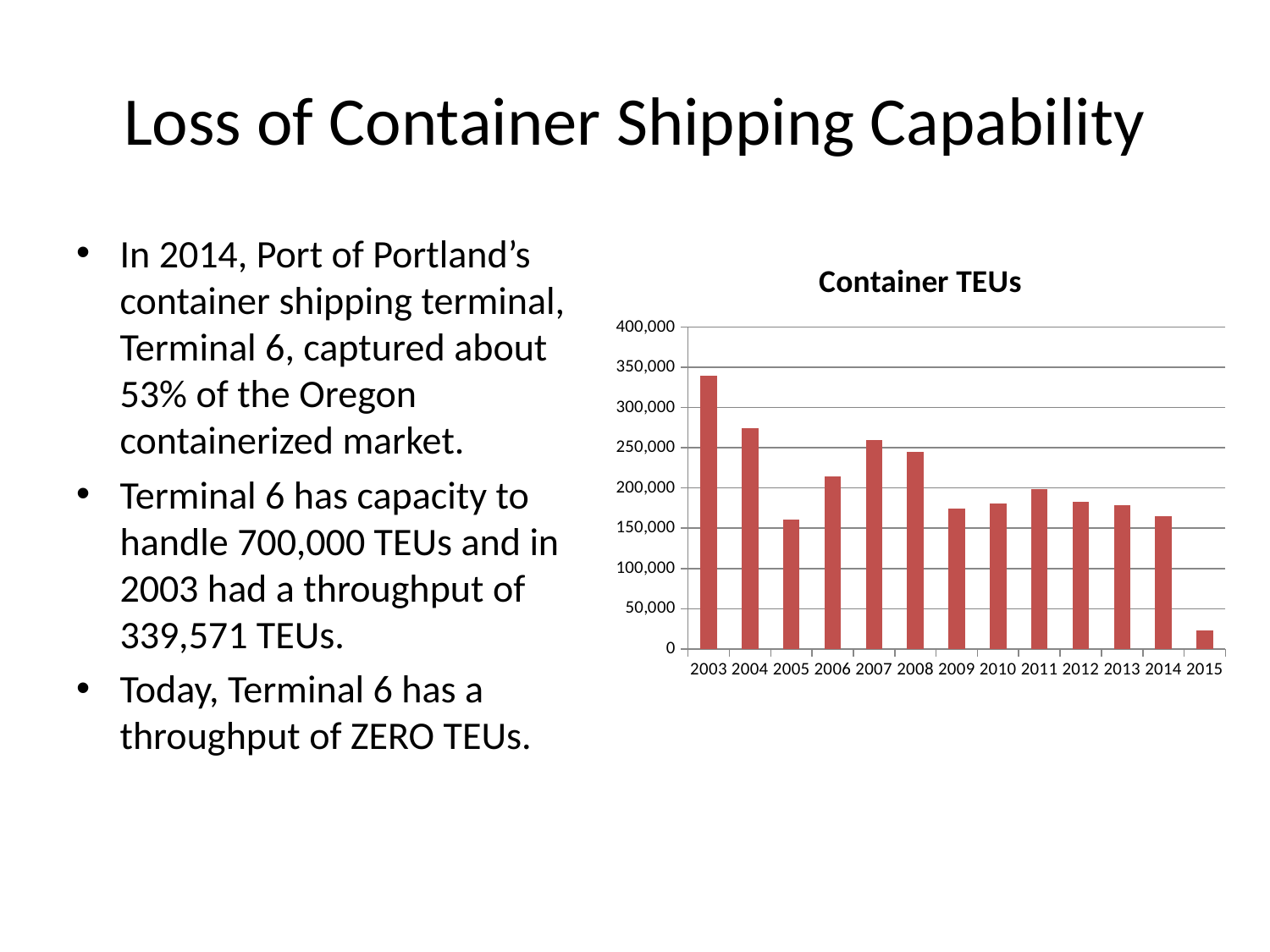
Is the value for 2003 greater or less than 300,000? greater Is the value for 2015 greater or less than 50,000? less Which is larger, the value for 2007 or the value for 2008? 2007 Overall, do the values rise or fall from 2003 to 2015? fall What is the title of the chart? Container TEUs What kind of chart is shown on the slide? bar chart How many years are plotted on the chart? 13 Which is larger, the value for 2004 or the value for 2005? 2004 Is the value for 2004 greater or less than 250,000? greater Which year has the lowest value on the chart? 2015 Which year has the highest value on the chart? 2003